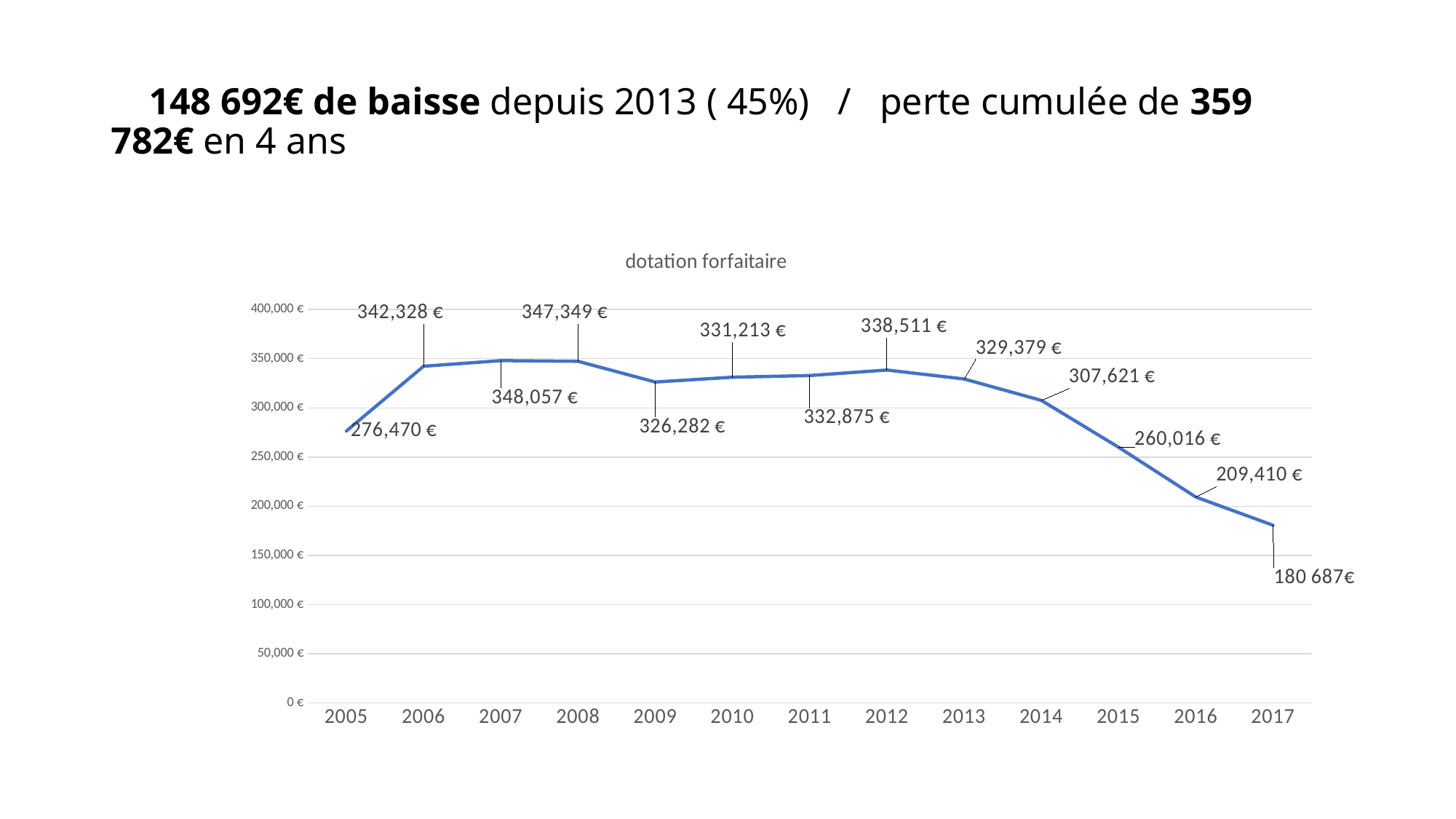
What is the value for 2013 on the dotation forfaitaire chart? 329,379 € Do the values on the dotation forfaitaire chart rise or fall from 2013 to 2017? Fall What kind of chart is the dotation forfaitaire chart? Line chart Which year has the highest value on the dotation forfaitaire chart? 2007 What is the value for 2017 on the dotation forfaitaire chart? 180 687€ Which is larger on the dotation forfaitaire chart, the value for 2006 or the value for 2009? 2006 What is the difference between the 2013 value and the 2017 value on the dotation forfaitaire chart? 148,692 € Which year has the lowest value on the dotation forfaitaire chart? 2017 What is the difference between the 2014 value and the 2015 value on the dotation forfaitaire chart? 47,605 € What is the value for 2005 on the dotation forfaitaire chart? 276,470 € What is the value for 2015 on the dotation forfaitaire chart? 260,016 € How many years are plotted on the dotation forfaitaire chart? 13